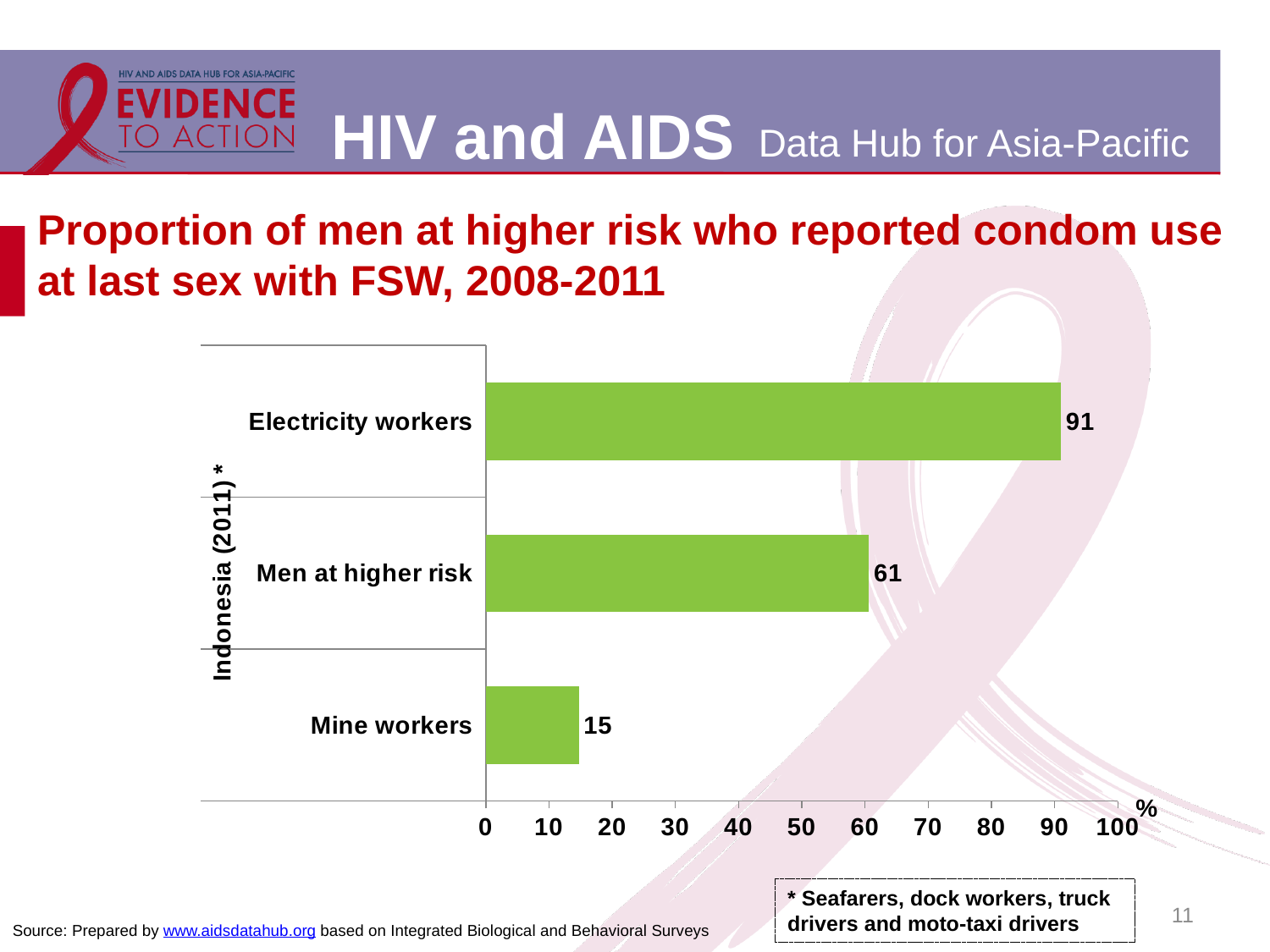
What country and year label appears on the vertical axis of the chart? Indonesia (2011) * Which is larger, the value for Men at higher risk or the value for Mine workers? Men at higher risk What is the value for Men at higher risk? 61 Which category has the highest value? Electricity workers What is the value for Electricity workers? 91 What is the difference between the values for Electricity workers and Men at higher risk? 30 What is the difference between the values for Electricity workers and Mine workers? 76 Is the value for Men at higher risk greater or less than 50? greater How many categories are shown in the chart? 3 Which category has the lowest value? Mine workers What kind of chart is shown on the slide? bar chart What is the value for Mine workers? 15